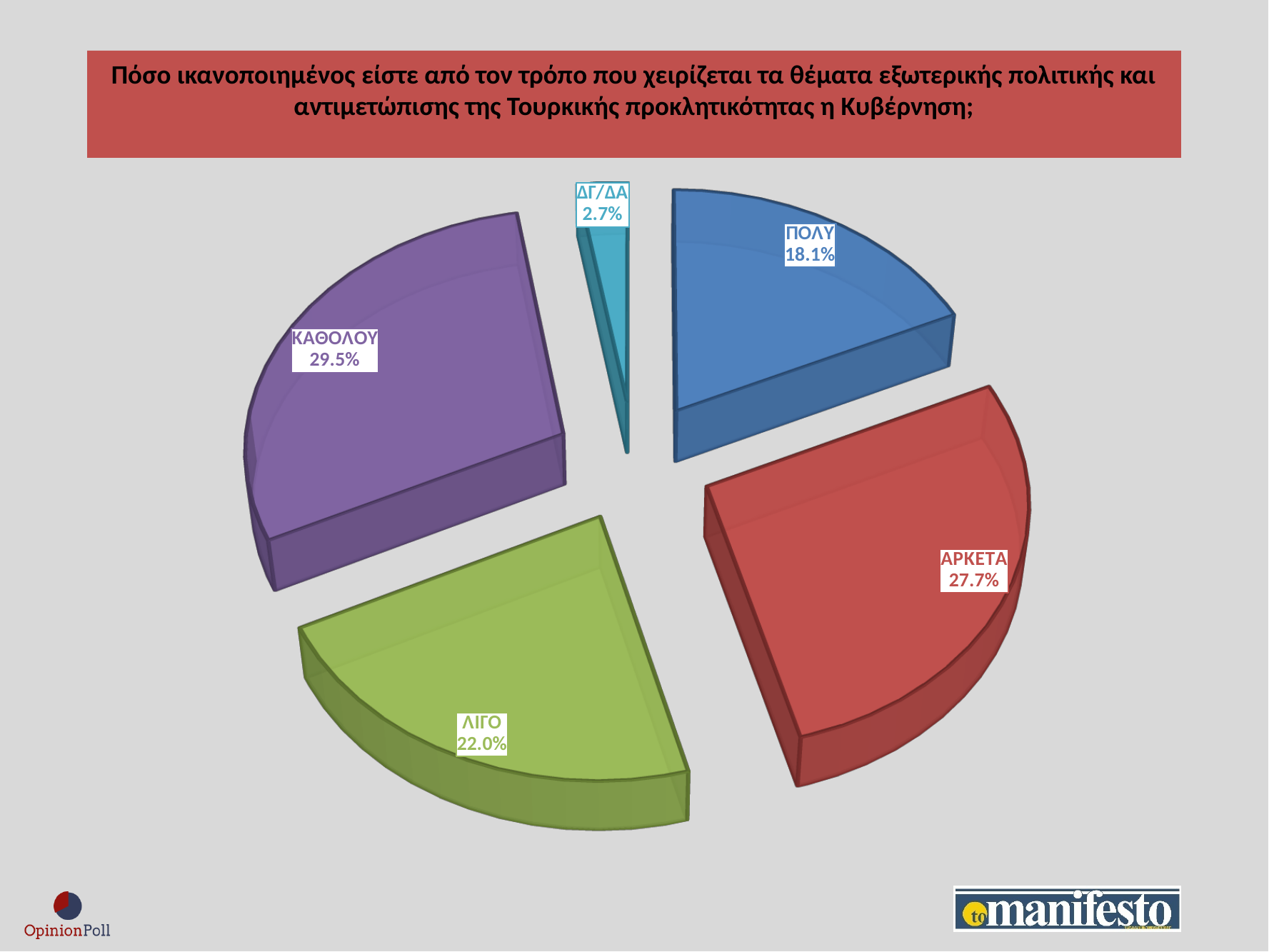
How many slices does the pie chart have? 5 What is the value shown for the ΔΓ/ΔΑ slice? 2.7% What is the difference in percentage points between ΚΑΘΟΛΟΥ and ΑΡΚΕΤΑ? 1.8 What percentage of respondents answered ΠΟΛΥ? 18.1% Which category has the largest share of the pie? ΚΑΘΟΛΟΥ Which is larger, the share for ΛΙΓΟ or the share for ΠΟΛΥ? ΛΙΓΟ What is the value shown for the ΛΙΓΟ slice? 22.0% What colour is the ΑΡΚΕΤΑ slice? Red What is the difference in percentage points between ΑΡΚΕΤΑ and ΠΟΛΥ? 9.6 What type of chart is shown on the slide? Pie chart What percentage of respondents answered ΚΑΘΟΛΟΥ? 29.5% Which category has the smallest share of the pie? ΔΓ/ΔΑ